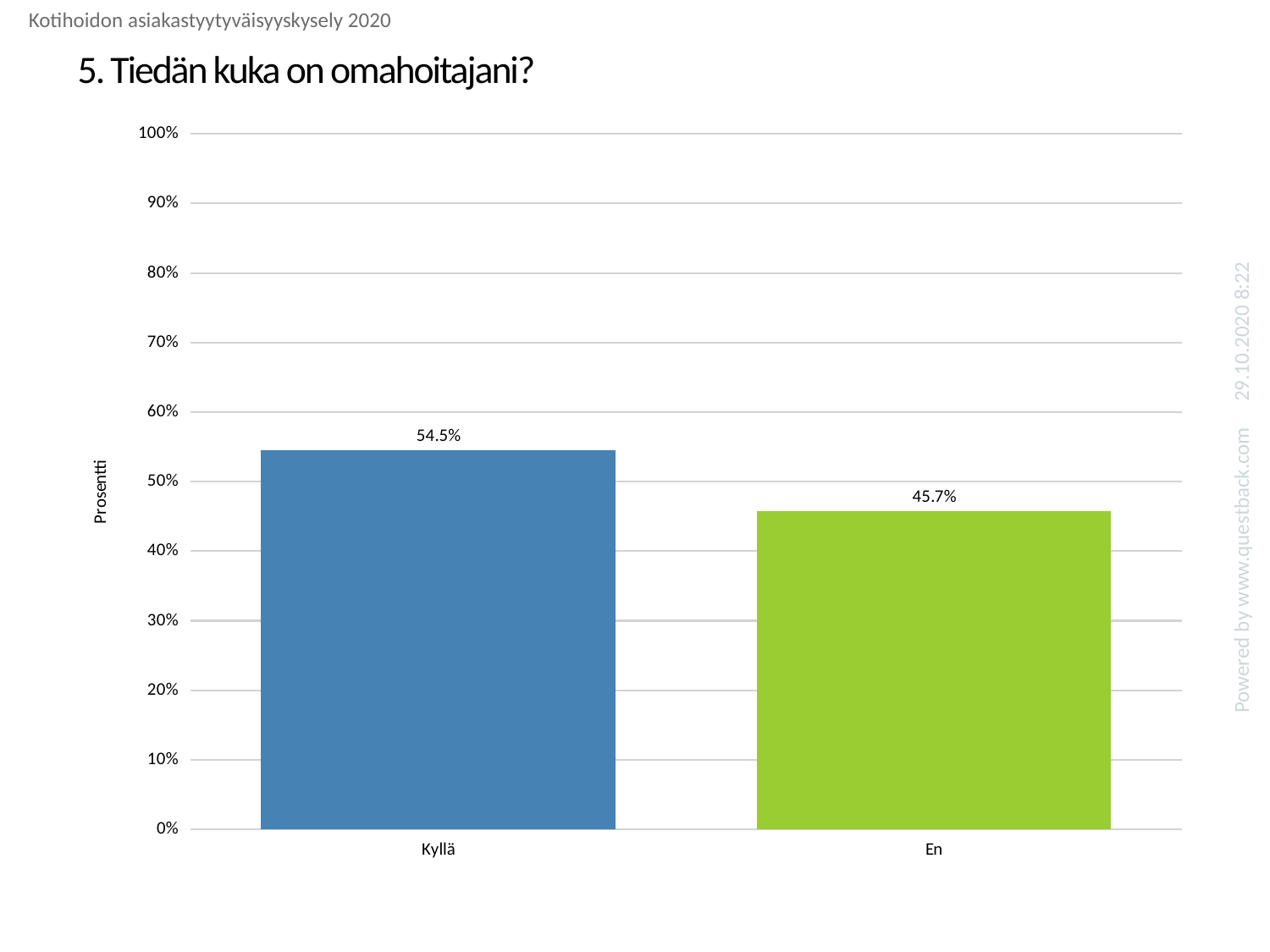
Is the value for En greater or less than 50%? less Is the value for Kyllä greater or less than 50%? greater What is the value for En? 45.7% What is the difference between the values for Kyllä and En? 8.8% What is the value for Kyllä? 54.5% How many categories are shown on the x axis? 2 What is the title of the chart? 5. Tiedän kuka on omahoitajani? Which category has the highest value? Kyllä What is the label of the y axis? Prosentti Which category has the lowest value? En Which is larger, the value for Kyllä or the value for En? Kyllä What kind of chart is shown on the slide? bar chart